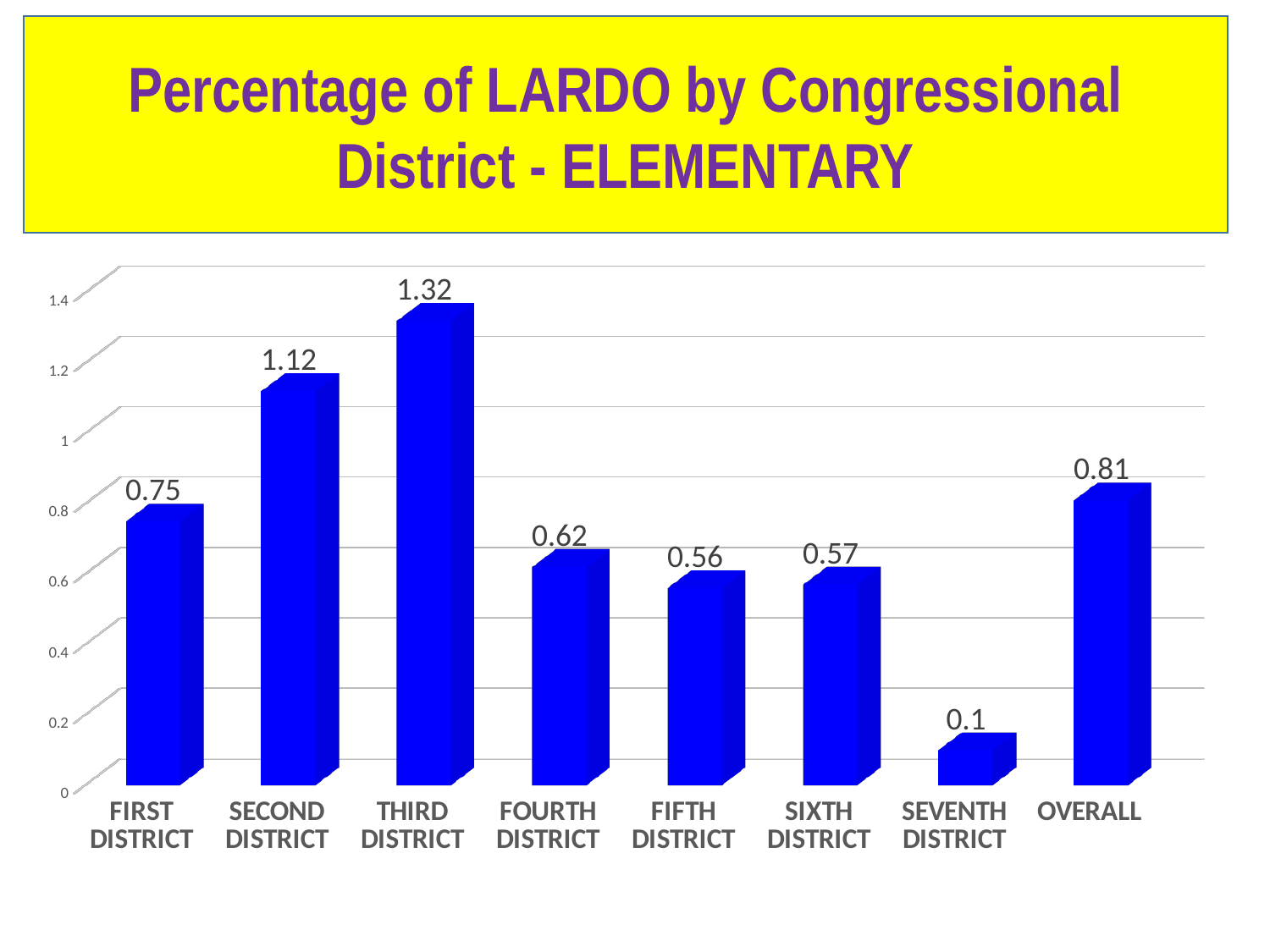
What is the title of the chart on the slide? Percentage of LARDO by Congressional District - ELEMENTARY Is the value for the Second District greater or less than 1? greater Which is larger, the value for the Fourth District or the Fifth District? Fourth District Which district has the lowest value? Seventh District How many bars are shown on the chart? 8 What is the Overall value shown on the chart? 0.81 What is the difference between the Third District and the Second District values? 0.2 What is the value for the Third District? 1.32 Which district has the highest value? Third District What kind of chart is shown on the slide? Bar chart What is the value for the Seventh District? 0.1 What is the difference between the First District and the Seventh District values? 0.65